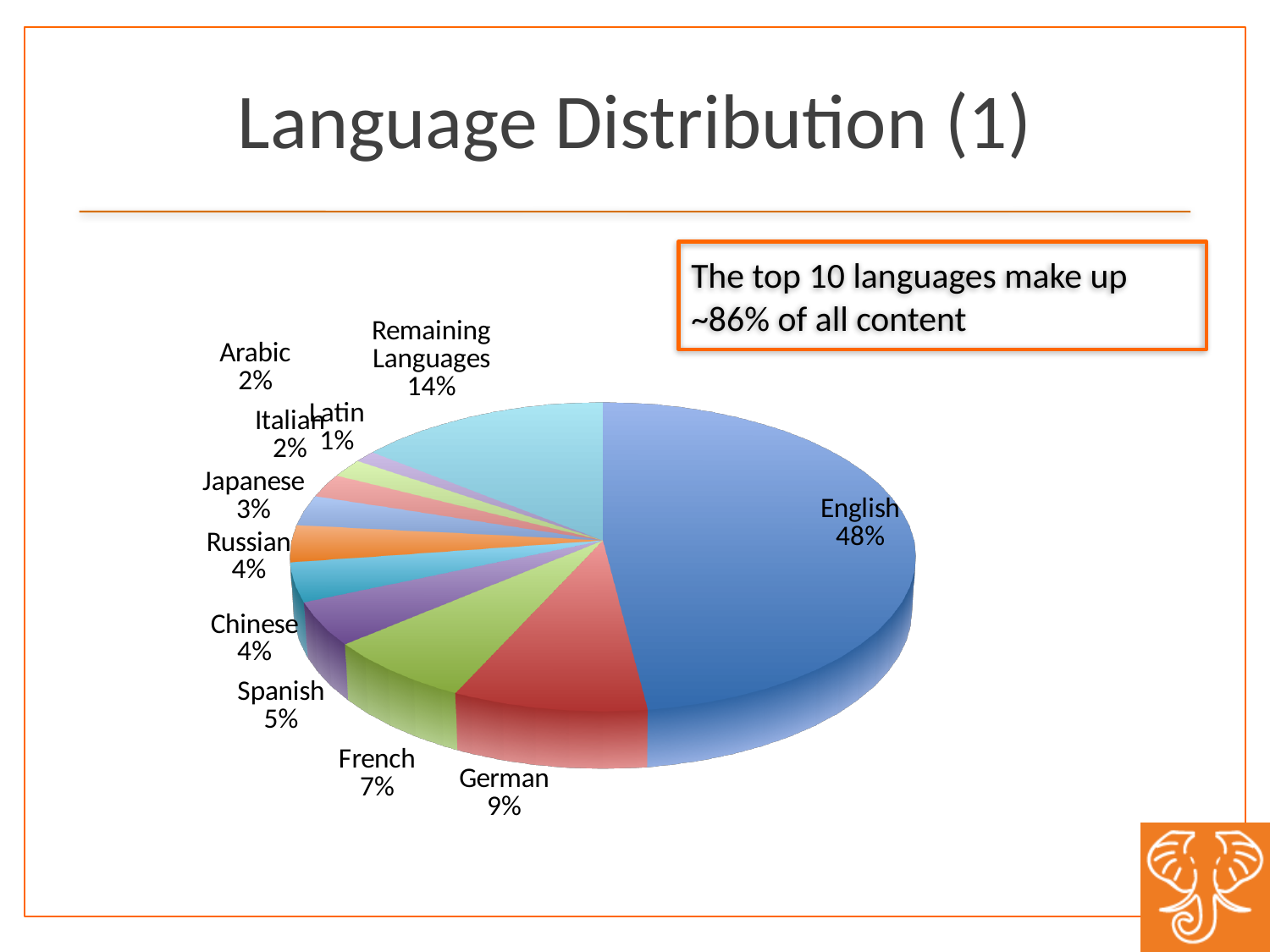
What is the value shown for German? 9% Which is larger, the share for French or the share for Chinese? French How many slices does the pie chart have? 11 What share of the pie does English account for? 48% What is the value shown for Remaining Languages? 14% Which slice of the pie is the largest? English What is the value shown for Japanese? 3% Which language has the smallest slice of the pie? Latin What is the difference between the shares for French and Spanish? 2% What is the title of the slide containing the pie chart? Language Distribution (1) What is the difference between the shares for English and German? 39% What kind of chart is shown on the slide? pie chart